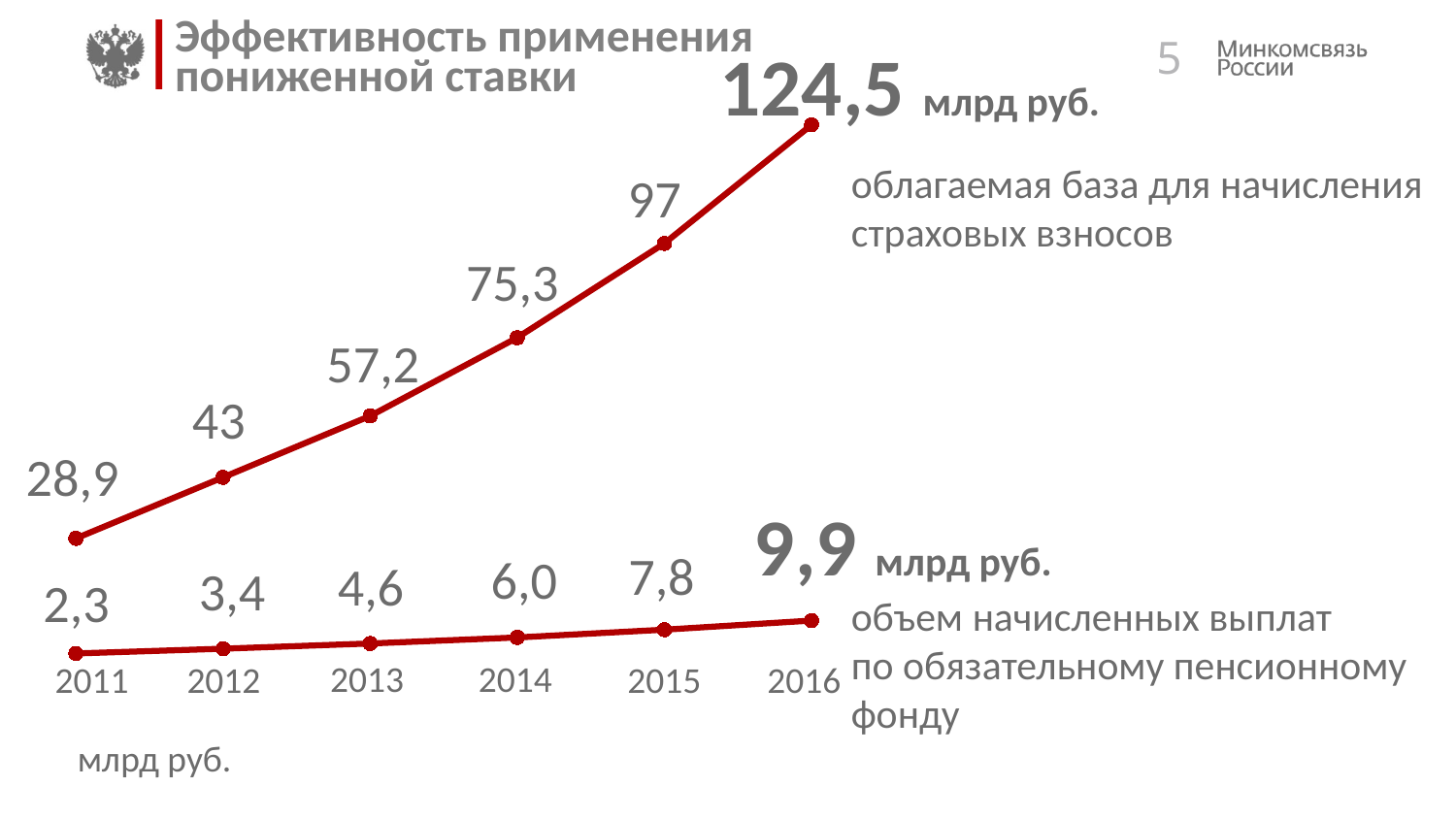
In which year is the volume of accrued payments to the pension fund the highest? 2016 By how much did the taxable base for insurance contributions grow from 2011 to 2016? 95,6 How many years are shown on the x axis of the chart? 6 In which year is the taxable base for insurance contributions the lowest? 2011 What is the value of the taxable base for insurance contributions (облагаемая база) in 2016? 124,5 млрд руб. What type of chart is shown on the slide? Line chart Which is larger: the taxable base in 2012 or the accrued pension payments in 2016? Taxable base in 2012 (43) What is the volume of accrued payments to the mandatory pension fund (объем начисленных выплат) in 2014? 6,0 What is the value of the taxable base for insurance contributions in 2013? 57,2 Does the taxable base for insurance contributions rise or fall from 2011 to 2016? Rises What is the volume of accrued payments to the mandatory pension fund in 2011? 2,3 What is the difference between the taxable base in 2015 and in 2014? 21,7